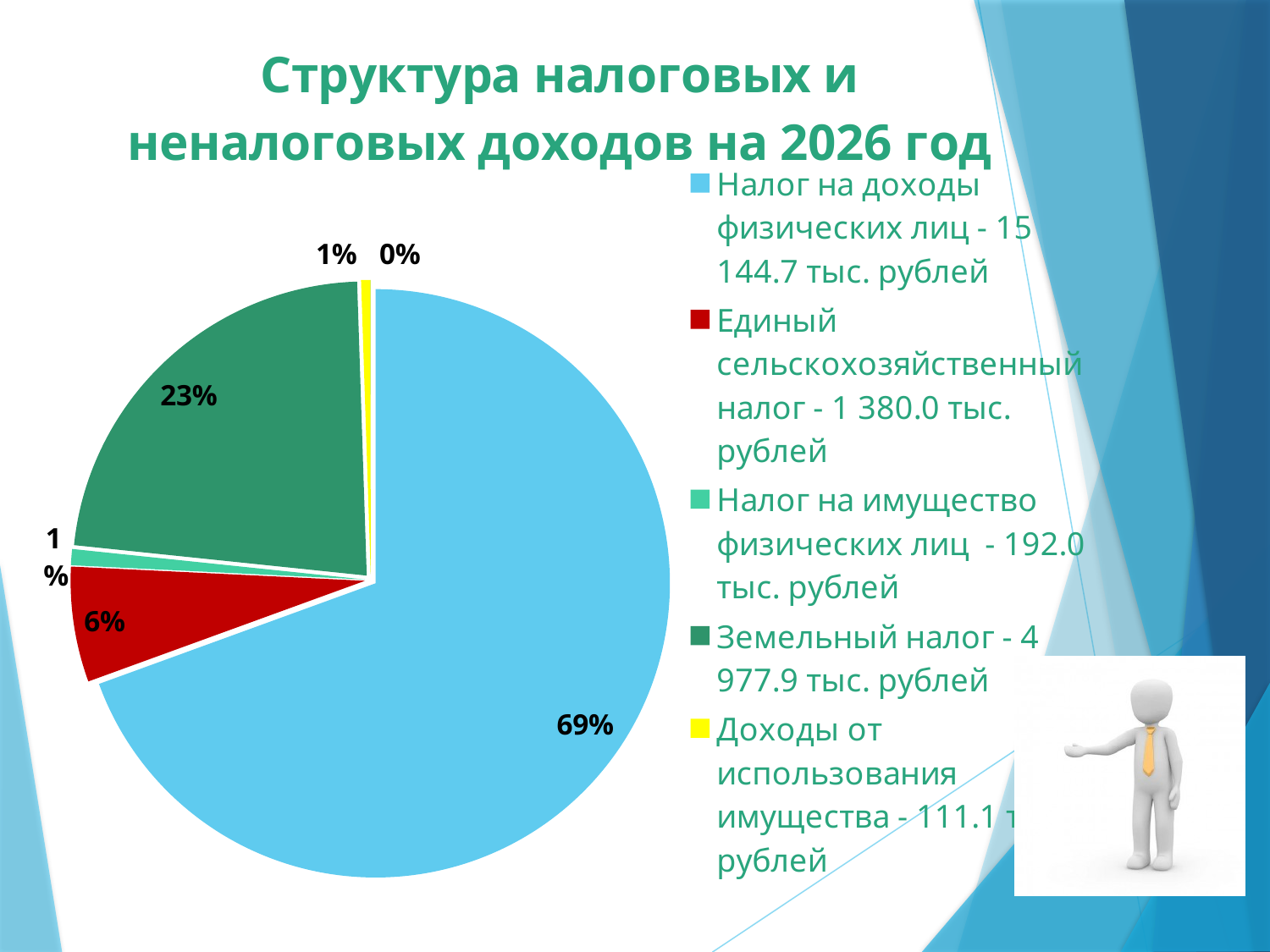
What colour is the slice for Единый сельскохозяйственный налог? red What is the difference in percentage points between the slice for Налог на доходы физических лиц and the slice for Земельный налог? 46 What is the title of the slide containing the chart? Структура налоговых и неналоговых доходов на 2026 год What kind of chart is shown on the slide? pie chart What share of the pie does Доходы от использования имущества take? 1% What share of the pie does Земельный налог take? 23% What share of the pie does Единый сельскохозяйственный налог take? 6% How many slices have percentage labels on the pie chart? 6 Which category has the largest slice of the pie? Налог на доходы физических лиц Which is larger: the slice for Земельный налог or the slice for Единый сельскохозяйственный налог? Земельный налог